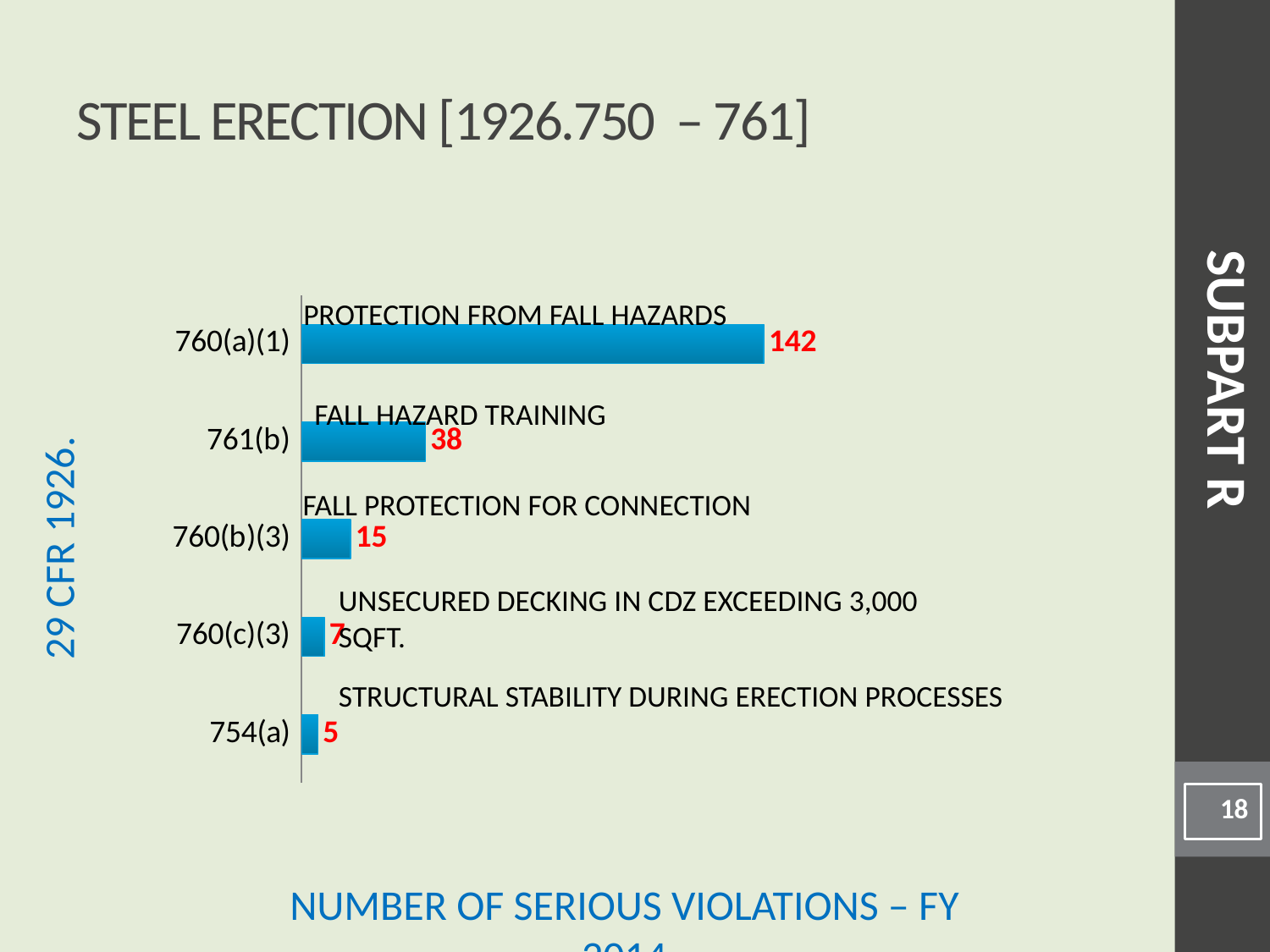
Which category has the lowest value? 754(a) What kind of chart is shown on the slide? bar chart What is the description label shown on the bar for 761(b)? FALL HAZARD TRAINING What is the value for 761(b)? 38 What is the difference between the values for 761(b) and 760(b)(3)? 23 What is the value for 760(a)(1)? 142 Which is larger, the value for 760(b)(3) or the value for 760(c)(3)? 760(b)(3) What is the value for 760(b)(3)? 15 What is the difference between the values for 760(a)(1) and 761(b)? 104 What is the value for 754(a)? 5 Which category has the highest value? 760(a)(1) How many categories are shown in the chart? 5